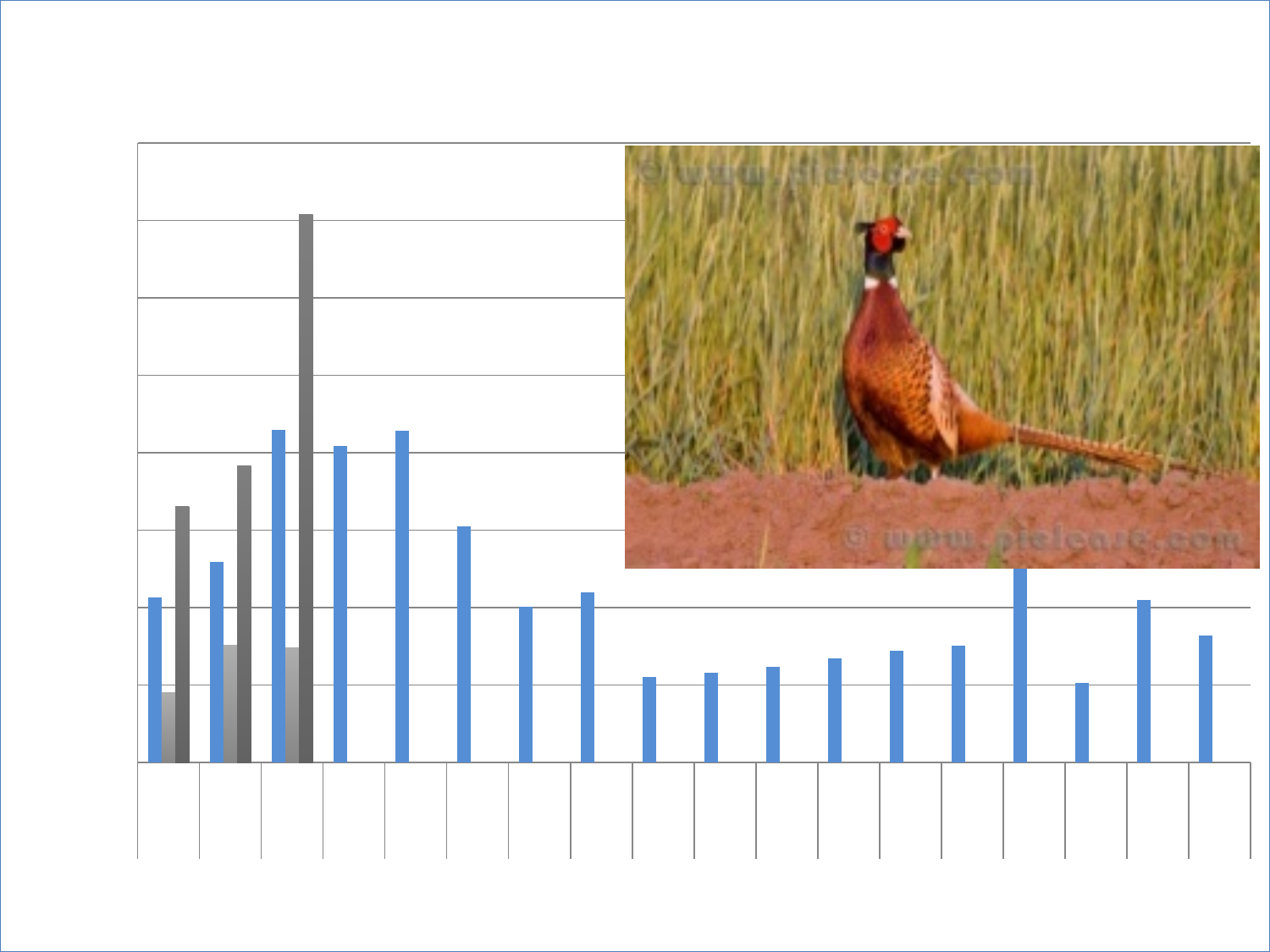
How many category groups contain gray bars in addition to a blue bar? 3 In the leftmost category group, which bar is shorter, the blue bar or the light gray bar? light gray What colour is the tallest bar in the chart? dark gray How many different bar colours appear in the chart? 3 What kind of chart is shown on the slide? bar chart How many category groups are plotted along the x axis of the chart? 18 In the leftmost category group, which bar is taller, the blue bar or the dark gray bar? dark gray How many blue bars are plotted in the chart? 18